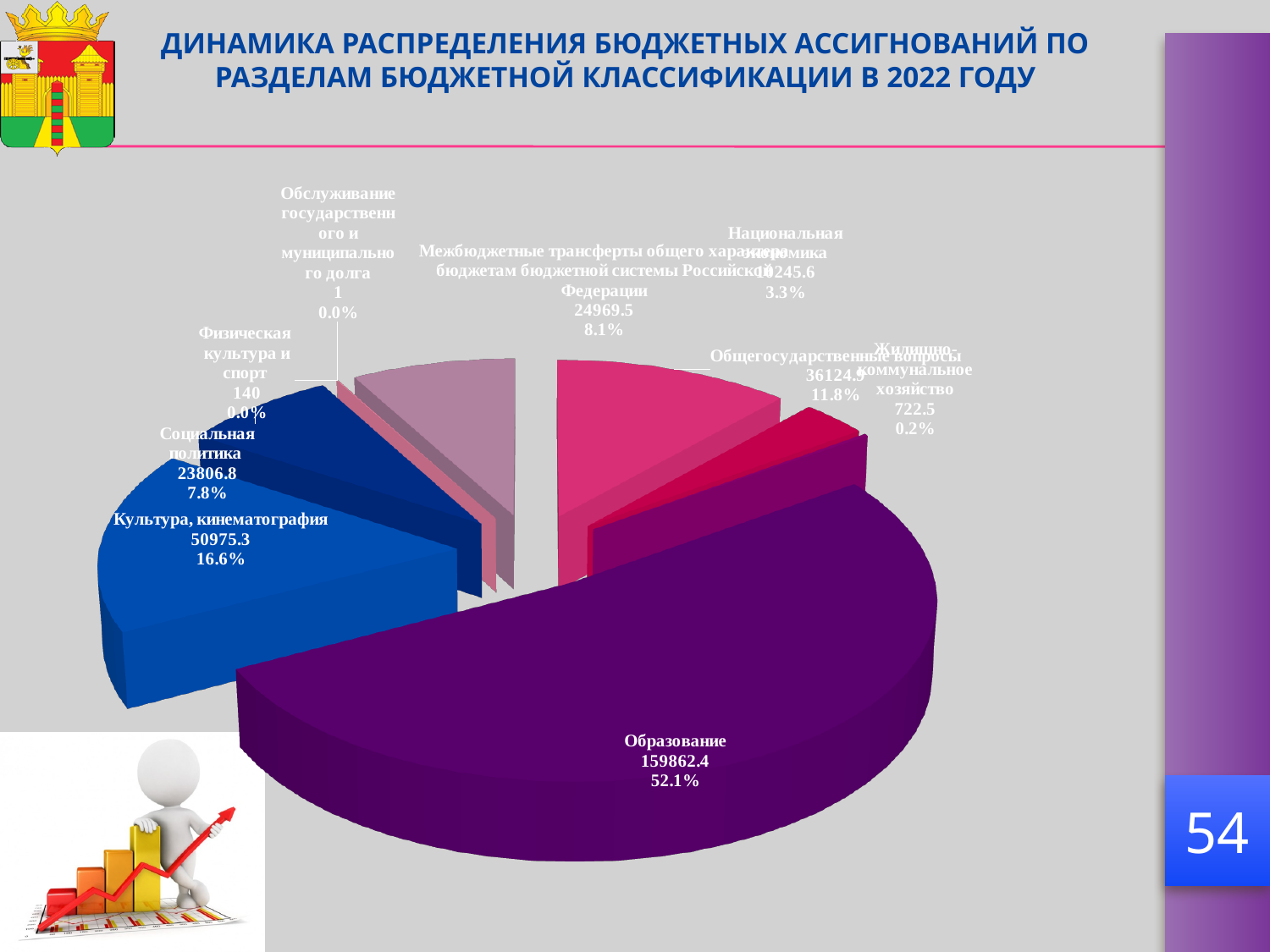
What share of the pie does Социальная политика take? 7.8% Which is larger: the value for Социальная политика or the value for Межбюджетные трансферты общего характера бюджетам бюджетной системы Российской Федерации? Межбюджетные трансферты общего характера бюджетам бюджетной системы Российской Федерации What is the difference between the values for Образование and Культура, кинематография? 108887.1 How many sections (slices) are shown in the pie chart? 9 Which section has the smallest value in the chart? Обслуживание государственного и муниципального долга What is the value shown for Образование? 159862.4 What kind of chart is shown on the slide? Pie chart What is the value shown for Физическая культура и спорт? 140 What share of the pie does Культура, кинематография take? 16.6% What is the value shown for Культура, кинематография? 50975.3 Which section has the largest slice of the pie? Образование What share of the pie does Образование take? 52.1%